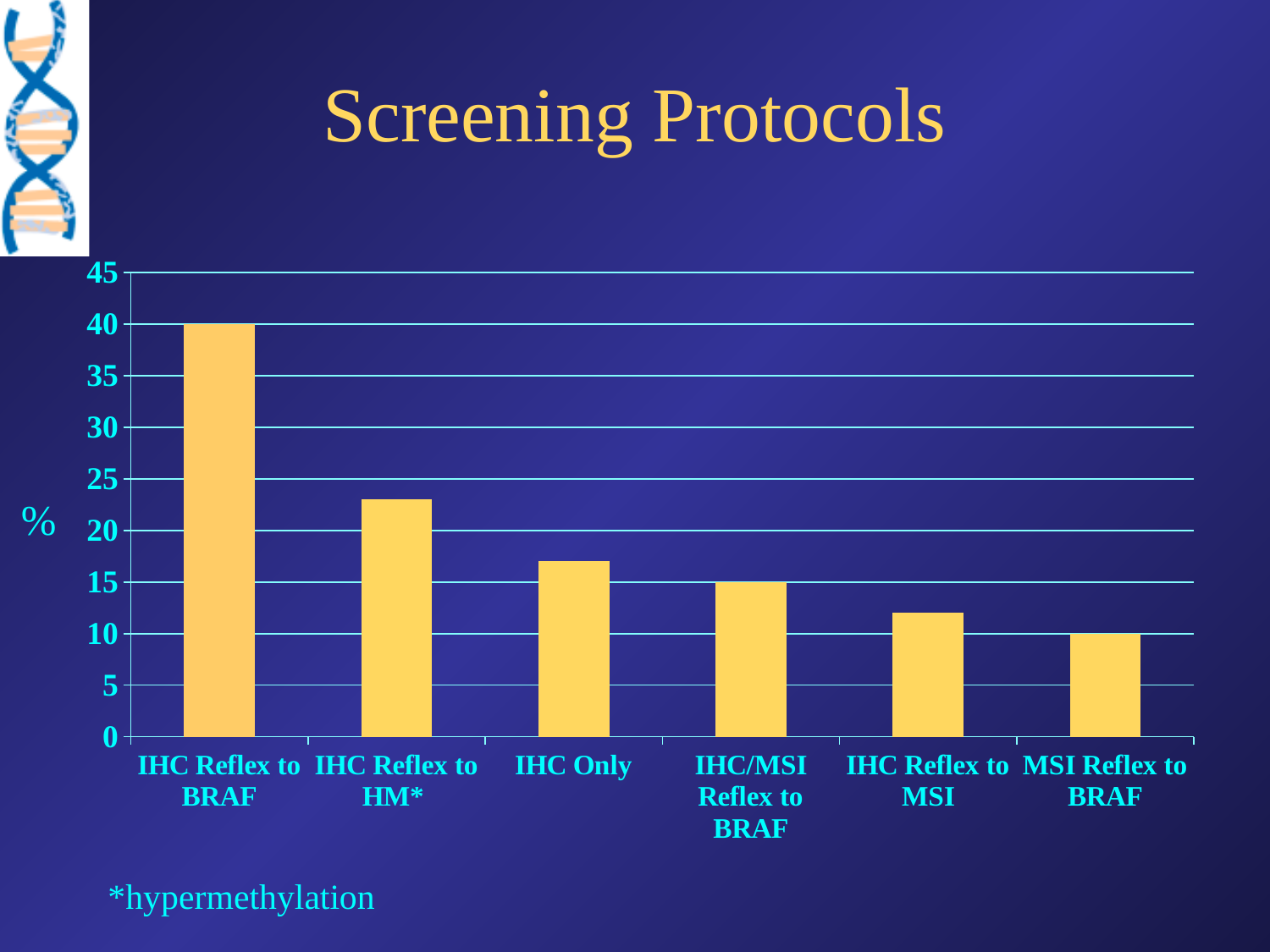
What is the difference between the values for IHC Reflex to BRAF and MSI Reflex to BRAF? 30 Is the value for IHC Reflex to MSI greater or less than 15? less What is the value for IHC/MSI Reflex to BRAF? 15 What is the value for MSI Reflex to BRAF? 10 Do the values rise or fall from left to right across the categories? fall Which screening protocol has the lowest value? MSI Reflex to BRAF Which is larger, the value for IHC Reflex to HM* or the value for IHC Only? IHC Reflex to HM* How many screening protocols are shown on the chart? 6 What kind of chart is shown on the slide? bar chart What is the value for IHC Reflex to BRAF? 40 Which screening protocol has the highest value? IHC Reflex to BRAF Is the value for IHC Reflex to HM* greater or less than 20? greater